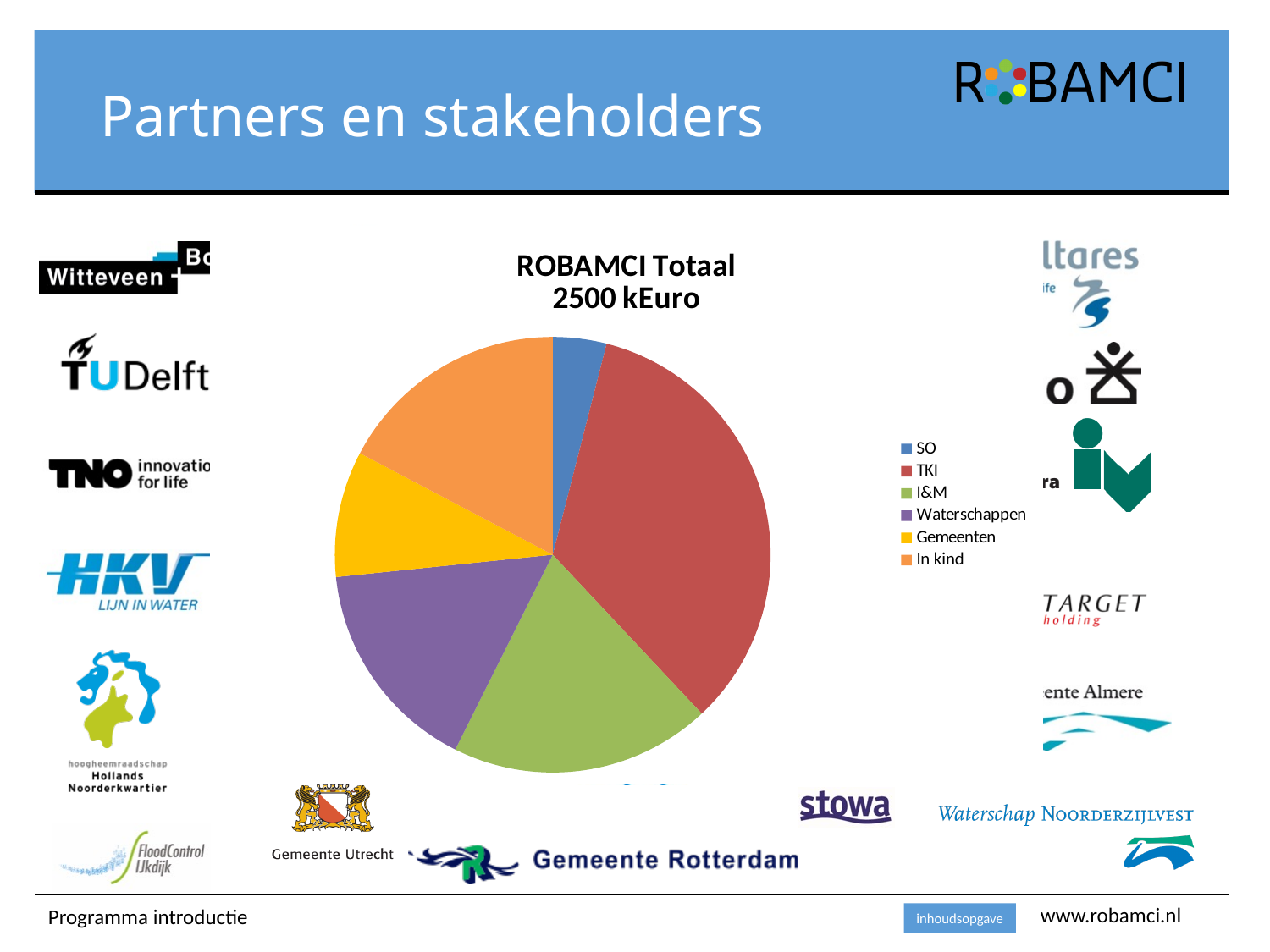
Which slice is larger, Waterschappen or SO? Waterschappen What is the title of the pie chart? ROBAMCI Totaal 2500 kEuro How many entries does the legend of the pie chart list? 6 What kind of chart is shown on the slide? pie chart Which slice is larger, In kind or Gemeenten? In kind Which category has the largest slice of the pie chart? TKI Which category has the smallest slice of the pie chart? SO Which slice is larger, SO or Gemeenten? Gemeenten How many slices does the pie chart have? 6 Which category is shown in red in the pie chart? TKI